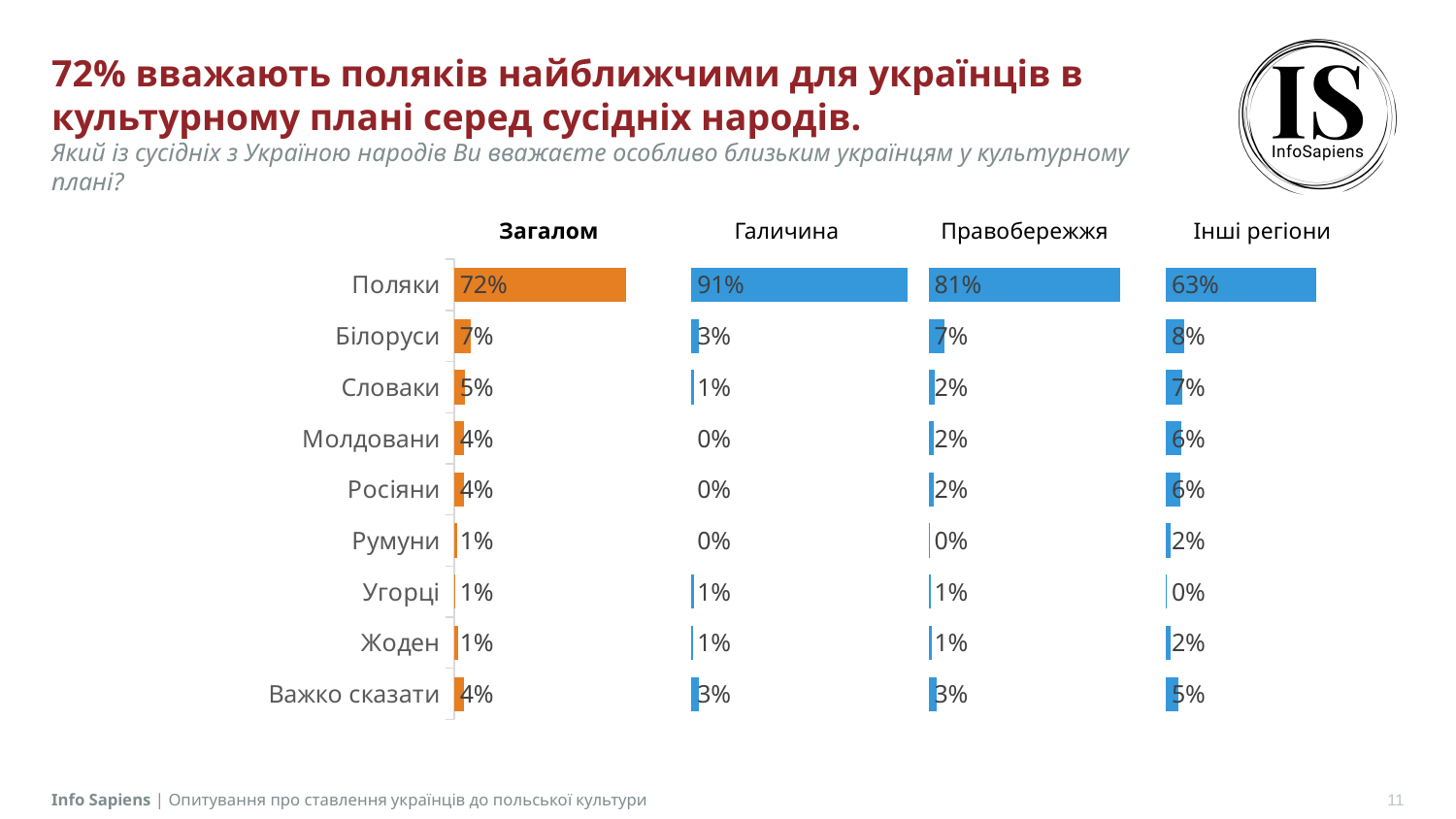
In the Загалом chart, what is the difference between the values for Поляки and Словаки? 67 percentage points How many categories are shown in the Загалом chart? 9 In the Галичина chart, what is the difference between the values for Поляки and Білоруси? 88 percentage points What colour are the bars in the Загалом chart? Orange What kind of chart is used for the Загалом column? Bar chart In the Галичина chart, what is the value for Поляки? 91% In the Правобережжя chart, which category has the highest value? Поляки In the Інші регіони chart, which is larger: the value for Словаки or the value for Румуни? Словаки In the Галичина chart, what is the value for Молдовани? 0% In the Загалом chart, what is the value for Поляки? 72% In the Правобережжя chart, what is the value for Важко сказати? 3% In the Інші регіони chart, what is the value for Білоруси? 8%